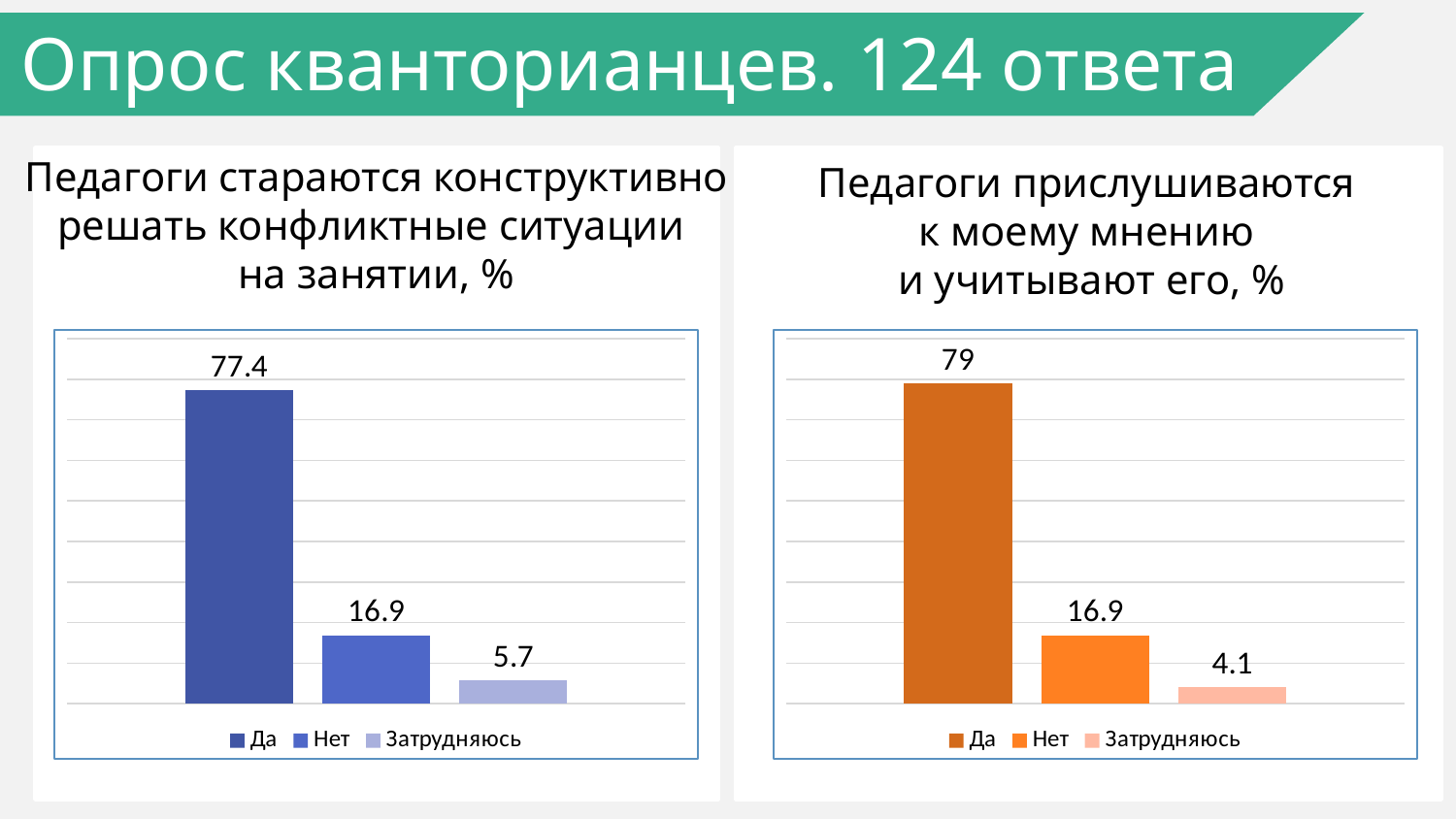
In the left chart (Педагоги стараются конструктивно решать конфликтные ситуации на занятии, %), what is the difference between the values for Да and Нет? 60.5 In the right chart (Педагоги прислушиваются к моему мнению и учитывают его, %), what is the value for Нет? 16.9 In the right chart (Педагоги прислушиваются к моему мнению и учитывают его, %), which category has the lowest value? Затрудняюсь How many entries does the legend of the left chart (Педагоги стараются конструктивно решать конфликтные ситуации на занятии, %) list? 3 How many bars are plotted in the right chart (Педагоги прислушиваются к моему мнению и учитывают его, %)? 3 In the right chart (Педагоги прислушиваются к моему мнению и учитывают его, %), what is the value for Да? 79 What type of chart is the left chart (Педагоги стараются конструктивно решать конфликтные ситуации на занятии, %)? Bar chart Which is larger: the value for Да in the left chart or the value for Да in the right chart? Да in the right chart (79) In the left chart (Педагоги стараются конструктивно решать конфликтные ситуации на занятии, %), what is the value for Да? 77.4 In the right chart (Педагоги прислушиваются к моему мнению и учитывают его, %), what is the difference between the values for Нет and Затрудняюсь? 12.8 In the left chart (Педагоги стараются конструктивно решать конфликтные ситуации на занятии, %), which category has the highest value? Да In the left chart (Педагоги стараются конструктивно решать конфликтные ситуации на занятии, %), what is the value for Затрудняюсь? 5.7